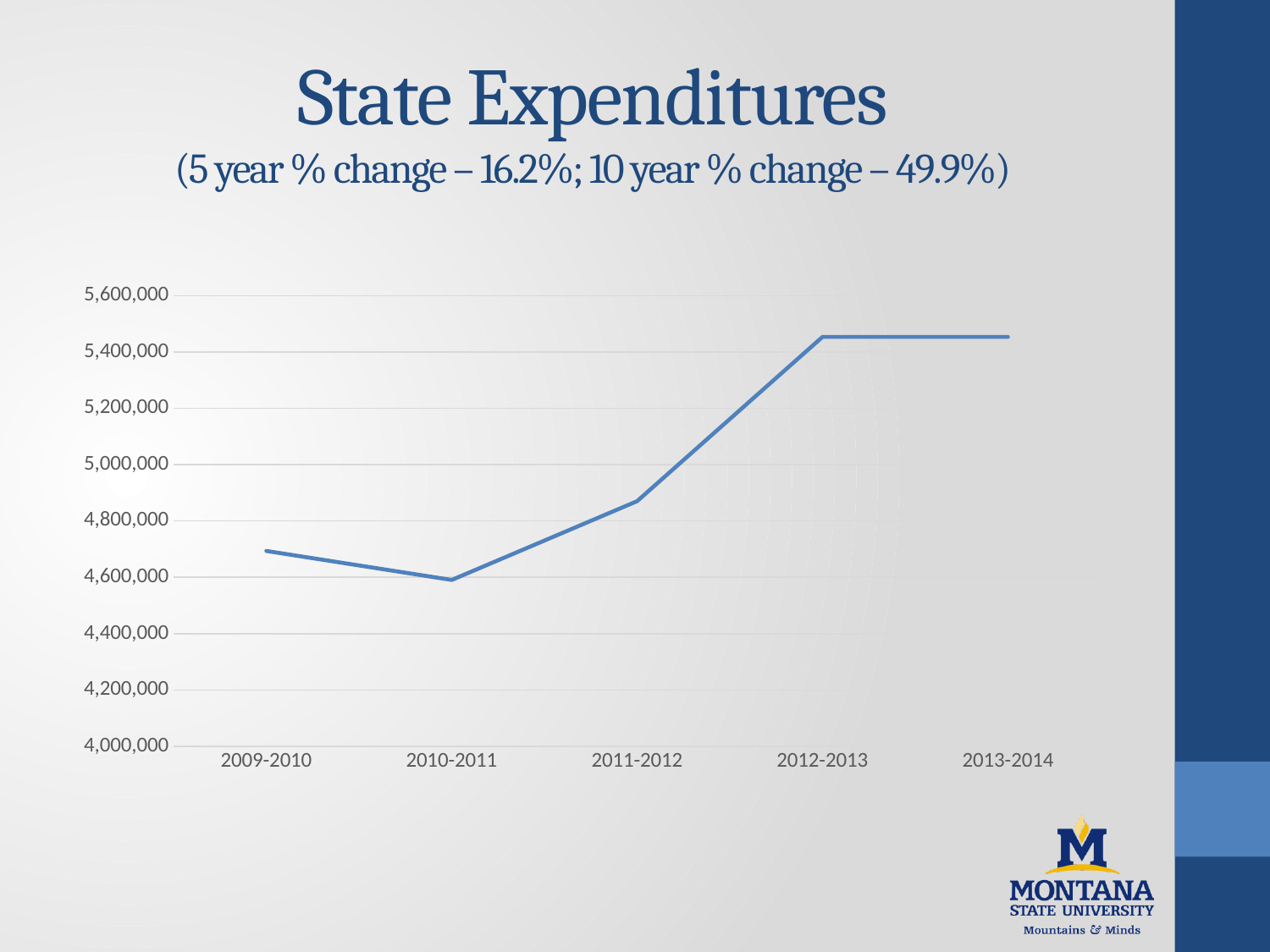
Which is larger, the value for 2011-2012 or the value for 2010-2011? 2011-2012 What kind of chart is shown on the slide? line chart What is the title of the chart on the slide? State Expenditures How many academic years are plotted on the x axis of the State Expenditures chart? 5 According to the slide subtitle, what is the 10 year % change in state expenditures? 49.9% Is the value for 2013-2014 greater or less than 5,600,000? less Is the value for 2012-2013 greater or less than 5,400,000? greater Is the value for 2009-2010 greater or less than 4,600,000? greater Do state expenditures overall rise or fall from 2009-2010 to 2013-2014? rise Which year has the lowest state expenditures on the chart? 2010-2011